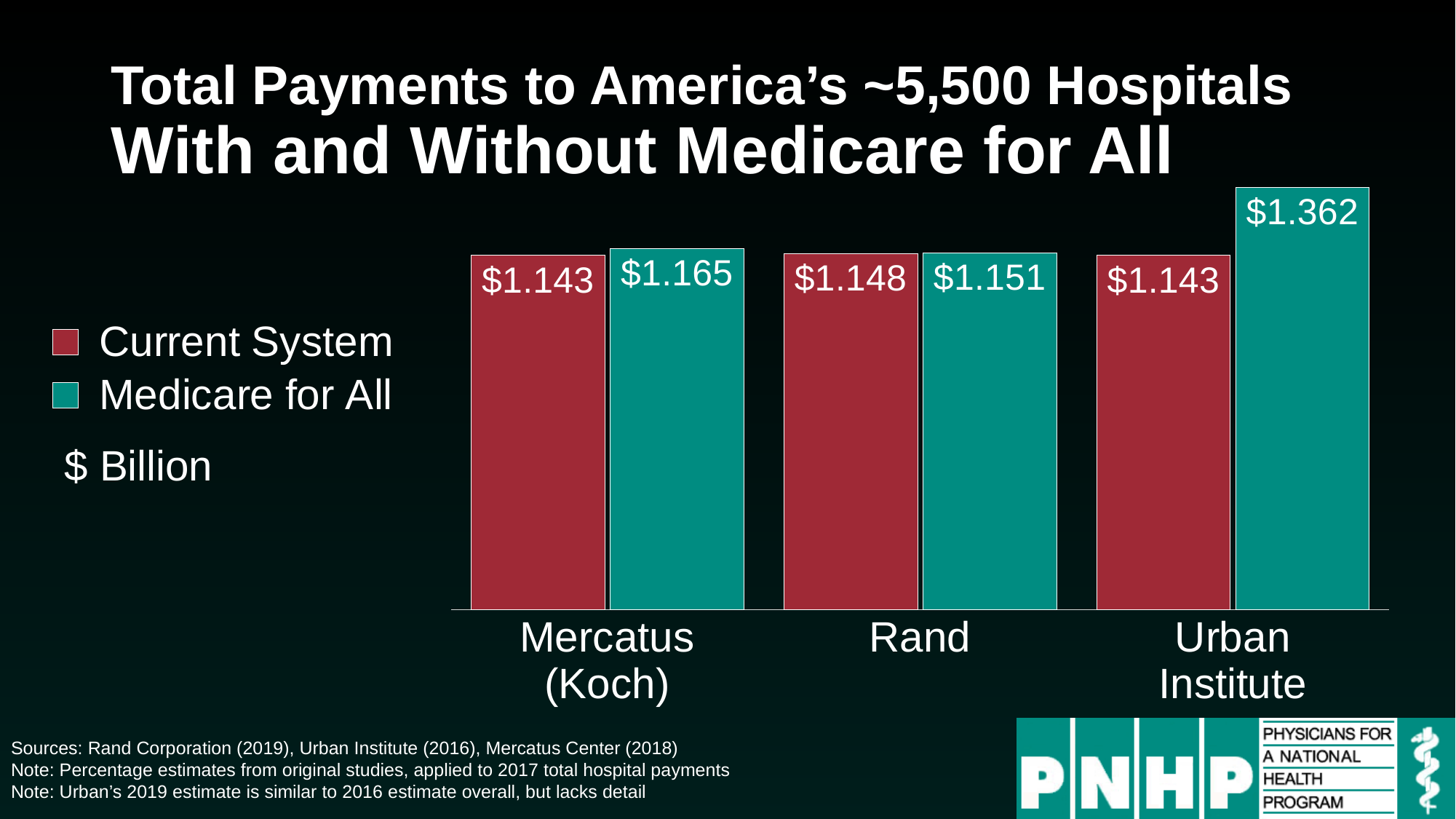
How many series does the legend list? 2 Which category has the lowest Medicare for All value? Rand What kind of chart is shown on the slide? Bar chart What is the Current System value for Mercatus (Koch)? $1.143 How many categories are shown on the x axis? 3 Which category has the highest Medicare for All value? Urban Institute Which is larger for Urban Institute: the Current System value or the Medicare for All value? Medicare for All What is the Current System value for Rand? $1.148 What is the Medicare for All value for Urban Institute? $1.362 What is the difference between the Medicare for All and Current System values for Mercatus (Koch)? $0.022 What is the Medicare for All value for Rand? $1.151 What is the difference between the Medicare for All and Current System values for Urban Institute? $0.219